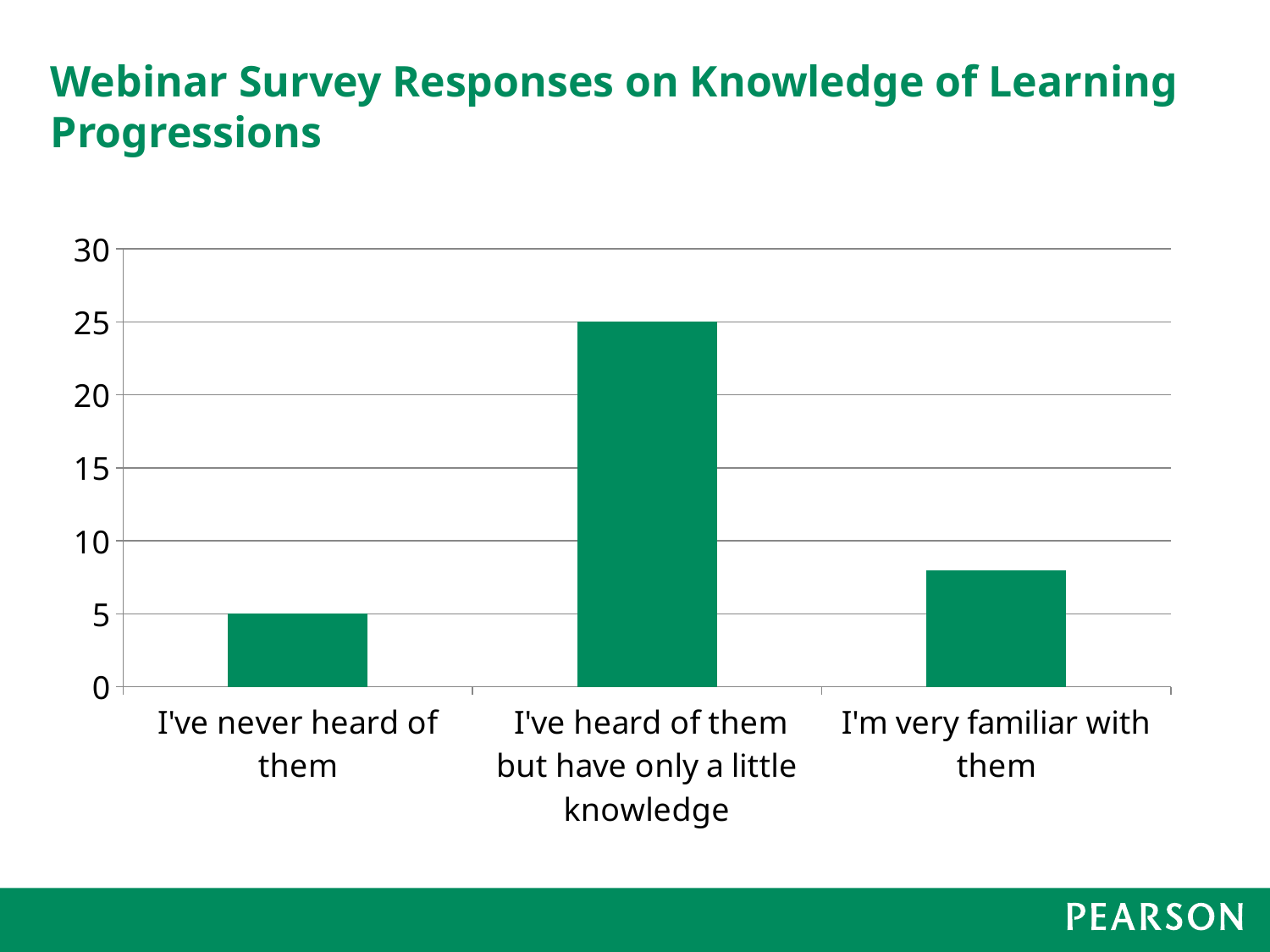
Which is larger, the value for "I'm very familiar with them" or the value for "I've never heard of them"? I'm very familiar with them What is the difference between the values for "I've heard of them but have only a little knowledge" and "I've never heard of them"? 20 Is the value for "I'm very familiar with them" greater or less than 10? less What is the title of the slide containing the chart? Webinar Survey Responses on Knowledge of Learning Progressions Is the value for "I'm very familiar with them" greater or less than 5? greater How many categories are plotted in the chart? 3 Which category has the lowest value? I've never heard of them What is the value for "I've heard of them but have only a little knowledge"? 25 What kind of chart is shown on the slide? bar chart Which category has the highest value? I've heard of them but have only a little knowledge What is the value for "I've never heard of them"? 5 What is the maximum value shown on the vertical axis? 30